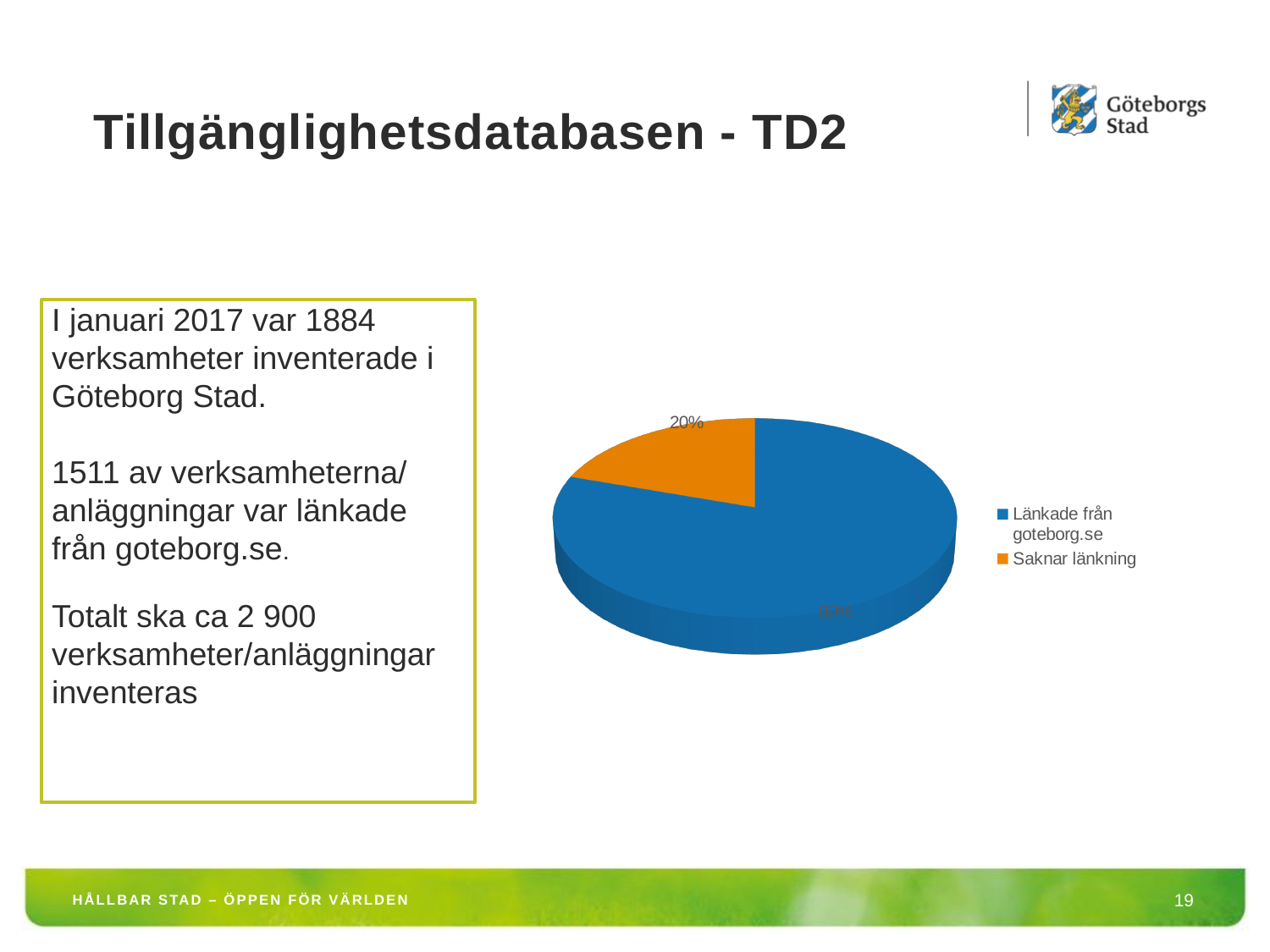
How many entries does the legend list? 2 How many slices does the pie chart have? 2 What share of the pie does the "Länkade från goteborg.se" slice represent? 80% What kind of chart is shown on the slide? pie chart Which slice of the pie is the smallest? Saknar länkning Which slice of the pie is the largest? Länkade från goteborg.se What colour is the "Länkade från goteborg.se" slice in the pie chart? blue Which is larger, the share for "Länkade från goteborg.se" or the share for "Saknar länkning"? Länkade från goteborg.se What is the difference in percentage points between the "Länkade från goteborg.se" slice and the "Saknar länkning" slice? 60 percentage points What share of the pie does the "Saknar länkning" slice represent? 20% What colour is the "Saknar länkning" slice in the pie chart? orange